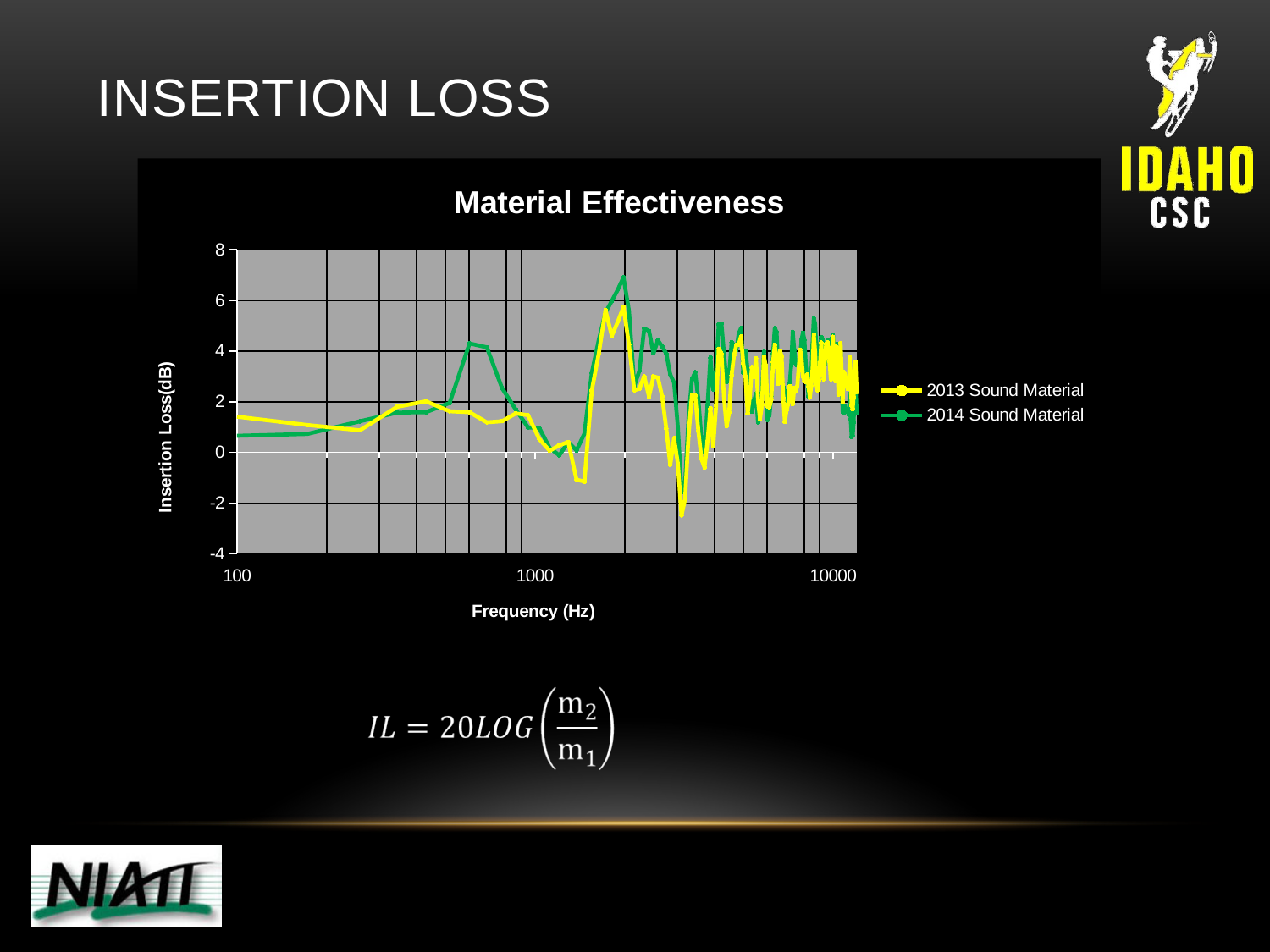
In the "Material Effectiveness" chart, which series has the higher value at 100 Hz, 2013 Sound Material or 2014 Sound Material? 2013 Sound Material What is the label of the vertical axis of the "Material Effectiveness" chart? Insertion Loss(dB) Which series in the "Material Effectiveness" chart reaches the highest insertion loss value? 2014 Sound Material What kind of chart is shown under the title "Material Effectiveness"? line chart In the "Material Effectiveness" chart, is the lowest value of the 2013 Sound Material series (near 3000 Hz) greater or less than -2? less In the "Material Effectiveness" chart, is the peak value of the 2014 Sound Material series near 2000 Hz greater or less than 6? greater In the "Material Effectiveness" chart, is the value of the 2014 Sound Material series at 100 Hz greater or less than 2? less In the "Material Effectiveness" chart, does the 2014 Sound Material series rise or fall between 100 Hz and about 600 Hz? rise In the "Material Effectiveness" chart, which series has the higher peak near 2000 Hz, 2013 Sound Material or 2014 Sound Material? 2014 Sound Material What is the title of the chart on the slide? Material Effectiveness How many series does the legend of the "Material Effectiveness" chart list? 2